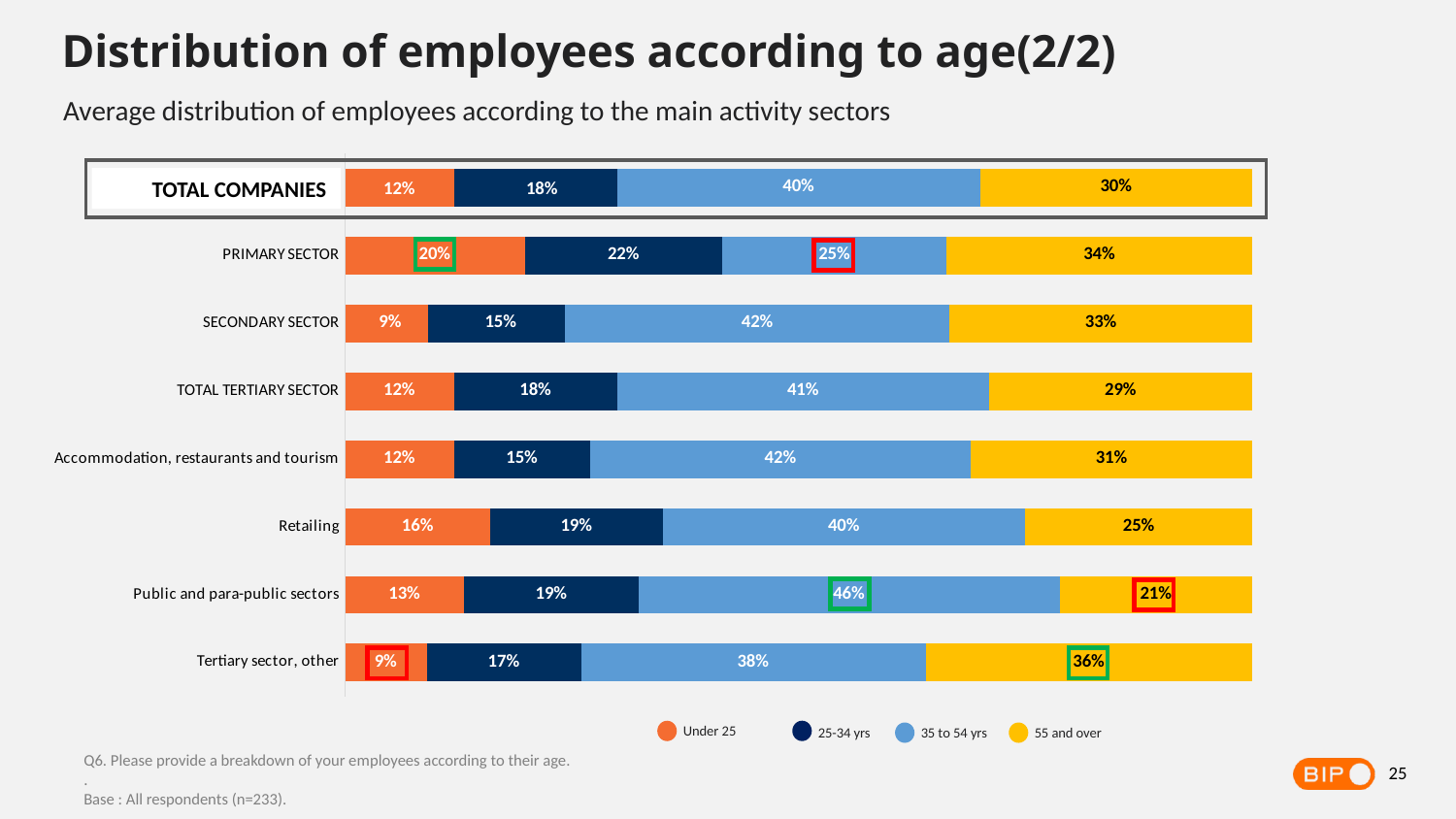
Which category has the highest share of employees aged 25-34 yrs? PRIMARY SECTOR What kind of chart is shown on the slide? Stacked bar chart Which has a larger share of employees Under 25: Retailing or SECONDARY SECTOR? Retailing What is the share of employees aged 55 and over in the Public and para-public sectors? 21% Which legend entry is shown in yellow? 55 and over Which category has the highest share of employees aged 35 to 54 yrs? Public and para-public sectors What is the difference between the 55 and over share for Tertiary sector, other and for Retailing? 11% How many categories (rows) are plotted in the chart? 8 Which category has the lowest share of employees aged 55 and over? Public and para-public sectors What is the share of employees aged 35 to 54 yrs for TOTAL COMPANIES? 40% What is the share of employees Under 25 in the PRIMARY SECTOR? 20% How many series does the legend list? 4